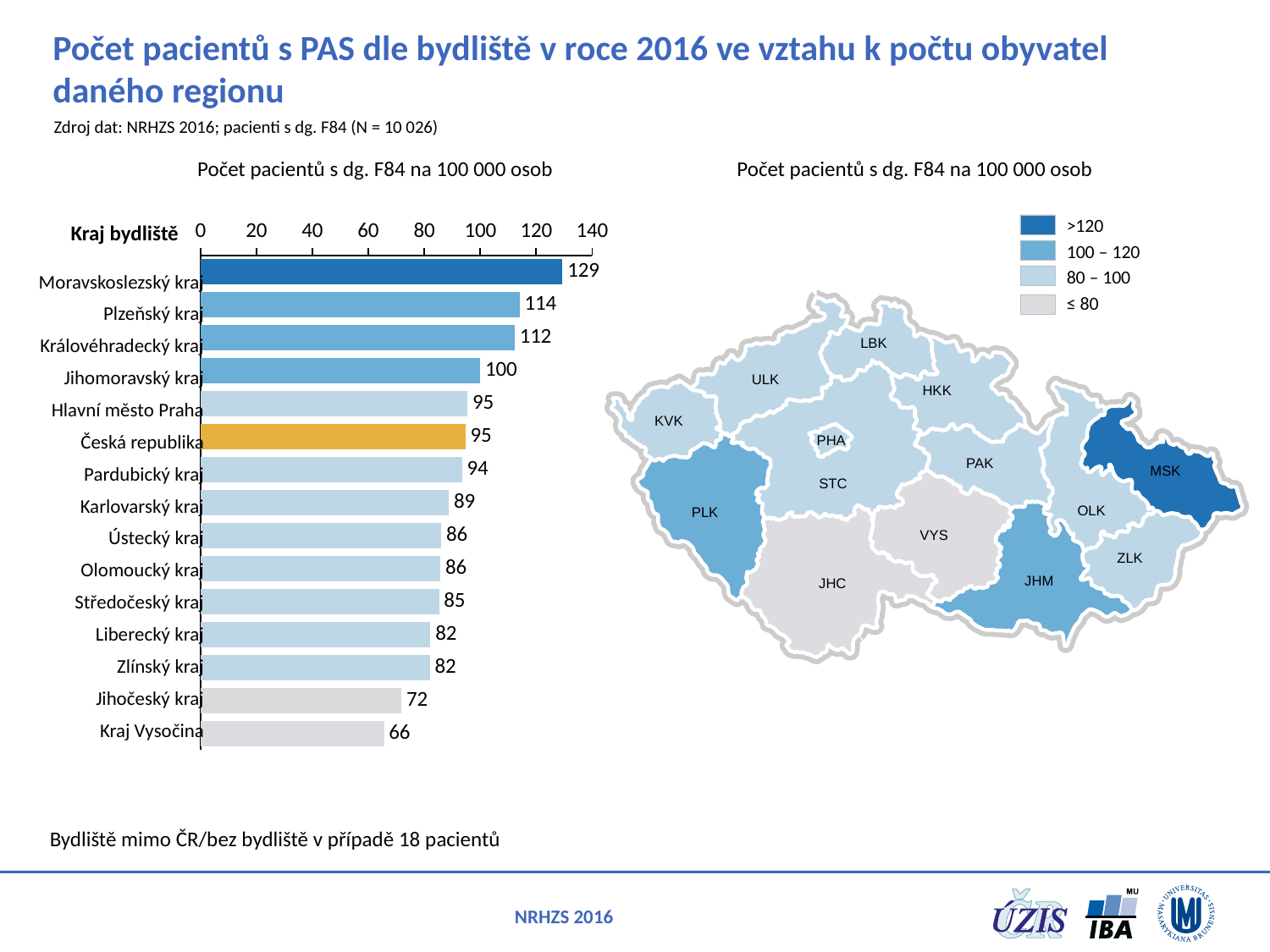
In the bar chart on the left, what is the value for Česká republika? 95 How many categories (bars) are shown in the bar chart on the left? 15 In the bar chart on the left, what is the difference between the values for Plzeňský kraj and Jihomoravský kraj? 14 In the bar chart on the left, what is the value for Kraj Vysočina? 66 In the bar chart on the left, what is the value for Moravskoslezský kraj? 129 In the bar chart on the left, which region has the lowest value? Kraj Vysočina In the bar chart on the left, which region has the highest value? Moravskoslezský kraj In the bar chart on the left, what is the difference between the values for Moravskoslezský kraj and Kraj Vysočina? 63 How many value ranges does the legend of the map on the right list? 4 What type of chart is shown on the left side of the slide? bar chart In the bar chart on the left, is the value for Jihočeský kraj greater or less than 80? less In the bar chart on the left, which has a larger value, Královéhradecký kraj or Pardubický kraj? Královéhradecký kraj